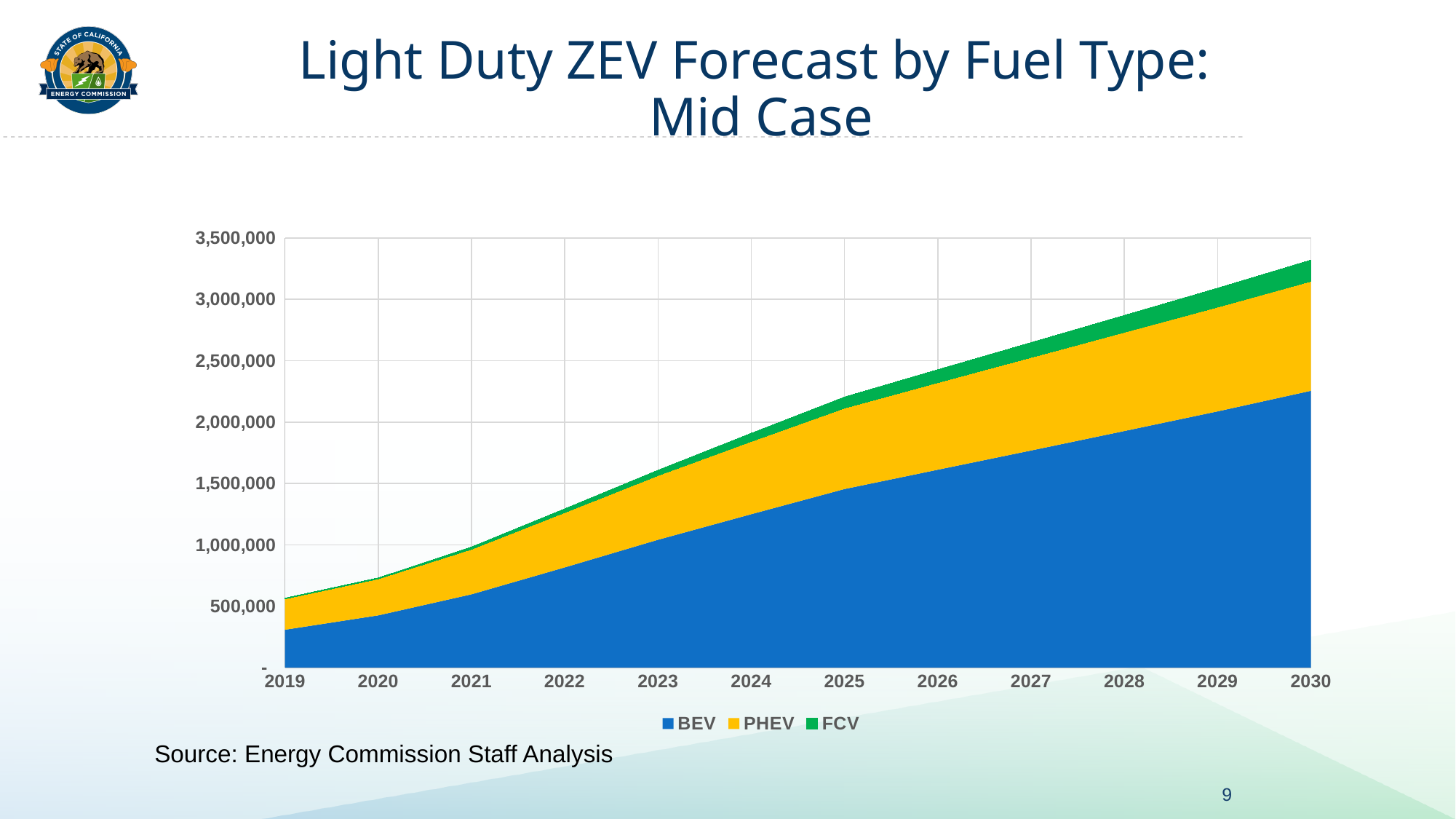
Is the total ZEV value for 2030 greater or less than 3,000,000? greater Is the total ZEV value for 2022 greater or less than 1,500,000? less In which year is the total light duty ZEV forecast lowest? 2019 What kind of chart is shown on the slide? Stacked area chart Is the BEV value for 2019 greater or less than 500,000? less Which colour represents PHEV in the chart? Yellow Do the total light duty ZEV values rise or fall from 2019 to 2030? Rise How many years are shown along the x axis? 12 In which year is the total light duty ZEV forecast highest? 2030 How many series does the legend list? 3 Which fuel type accounts for the largest share of the forecast in 2030, BEV or FCV? BEV